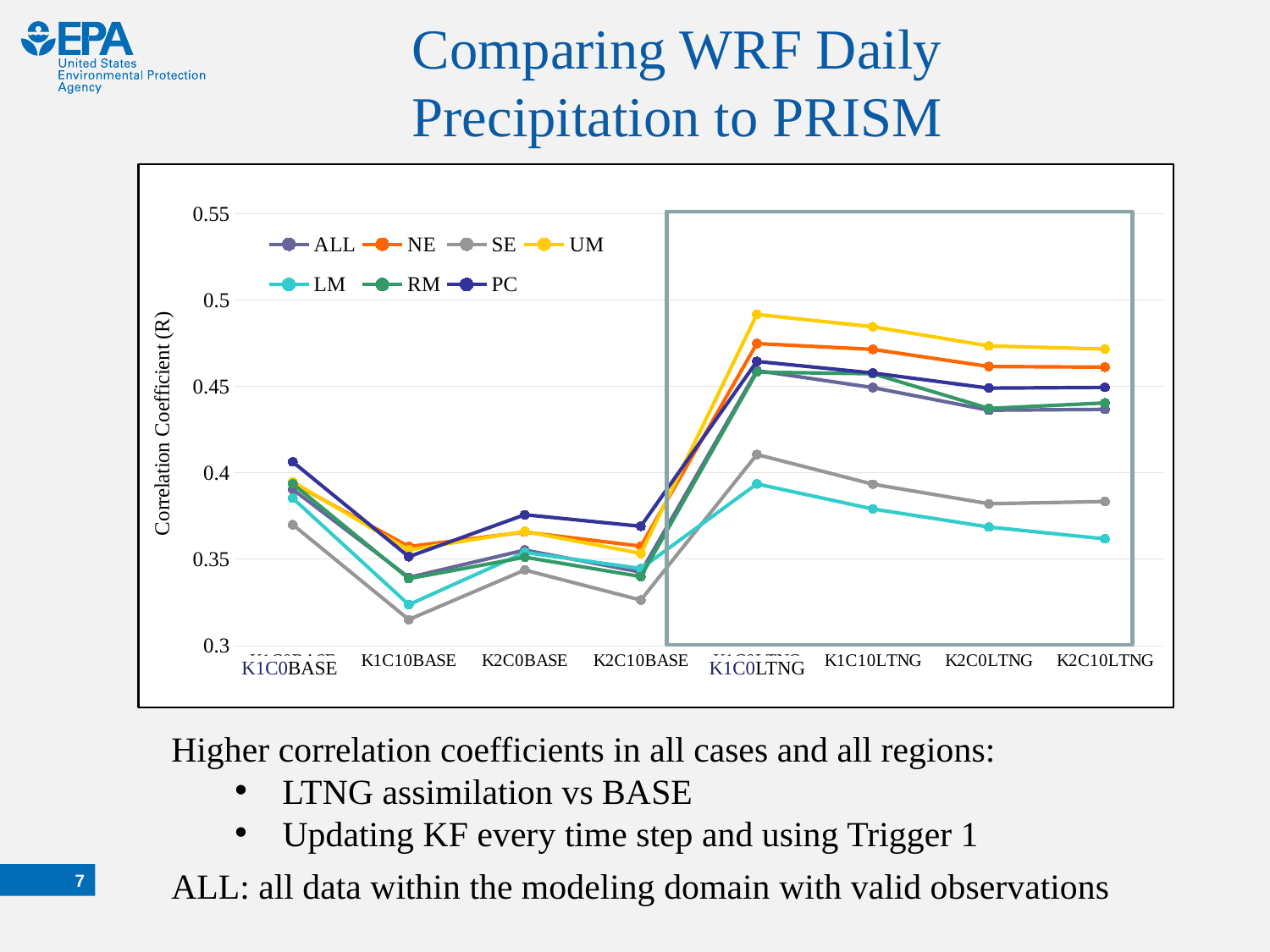
What is the label on the y axis? Correlation Coefficient (R) How many categories are shown along the x axis? 8 Which series has the lowest value at K1C10BASE? SE Is the value for UM at K1C0LTNG greater or less than 0.45? greater Is the value for LM at K2C10LTNG greater or less than 0.4? less Do the values for UM rise or fall from K1C0LTNG to K2C10LTNG? fall How many series does the legend list? 7 Which series has the lowest value at K2C10LTNG? LM What kind of chart is shown on the slide? line chart Which series has the highest value at K1C0LTNG? UM At K2C0LTNG, which is larger, the value for NE or the value for LM? NE Is the value for SE at K1C10BASE greater or less than 0.35? less